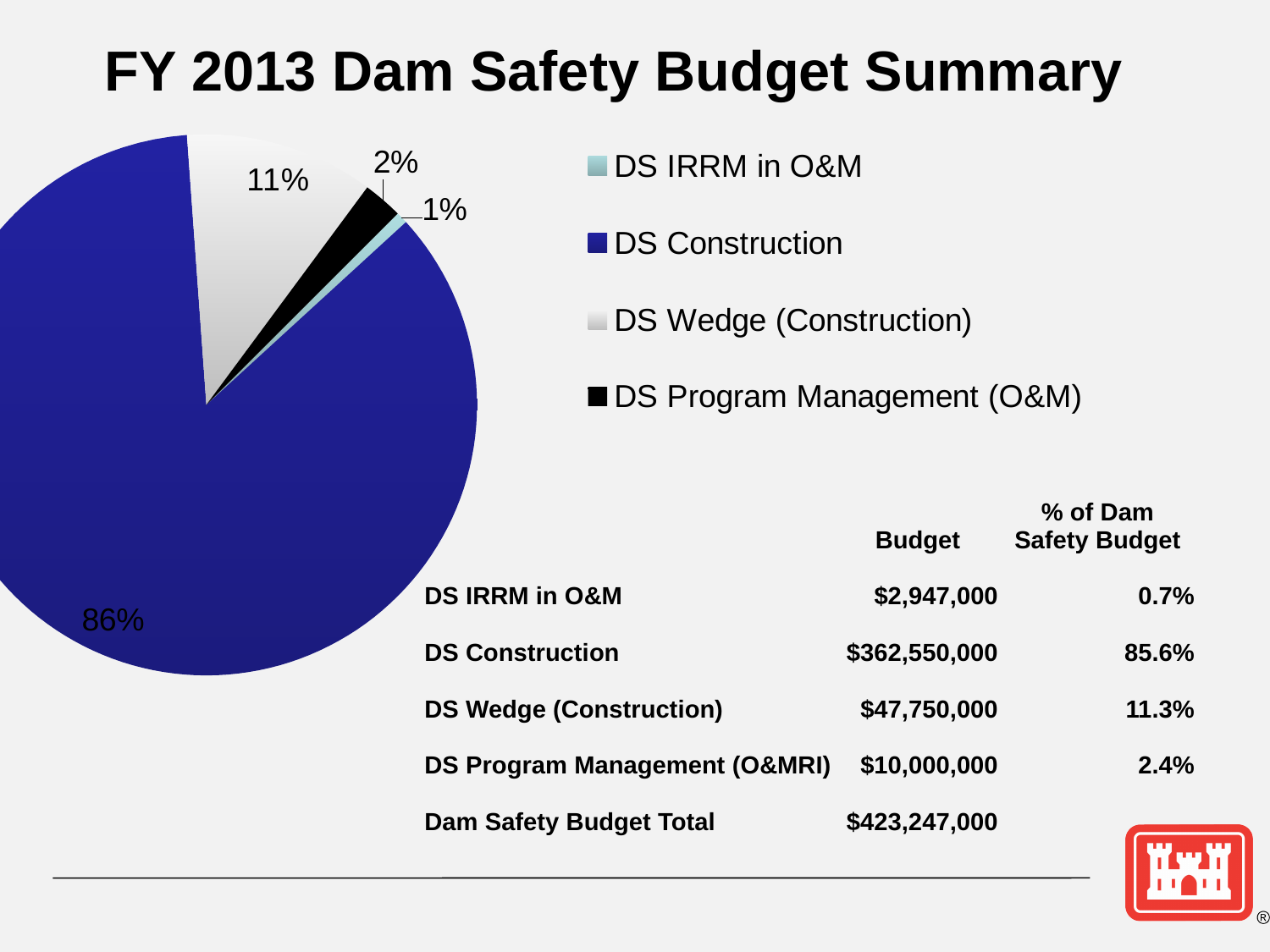
What is the difference in percentage points between the DS Construction slice and the DS Wedge (Construction) slice, using the pie labels? 75% Which category has the smallest slice of the pie? DS IRRM in O&M What percentage of the pie does DS Construction account for, according to the data label? 86% What colour is the DS Construction slice in the pie chart? dark blue What kind of chart is shown on the slide? pie chart How many entries does the legend list? 4 What percentage label is shown for the DS Program Management (O&M) slice? 2% What percentage label is shown for the DS IRRM in O&M slice? 1% Which slice is larger, DS Wedge (Construction) or DS Program Management (O&M)? DS Wedge (Construction) How many slices does the pie chart have? 4 Which category has the largest slice of the pie? DS Construction